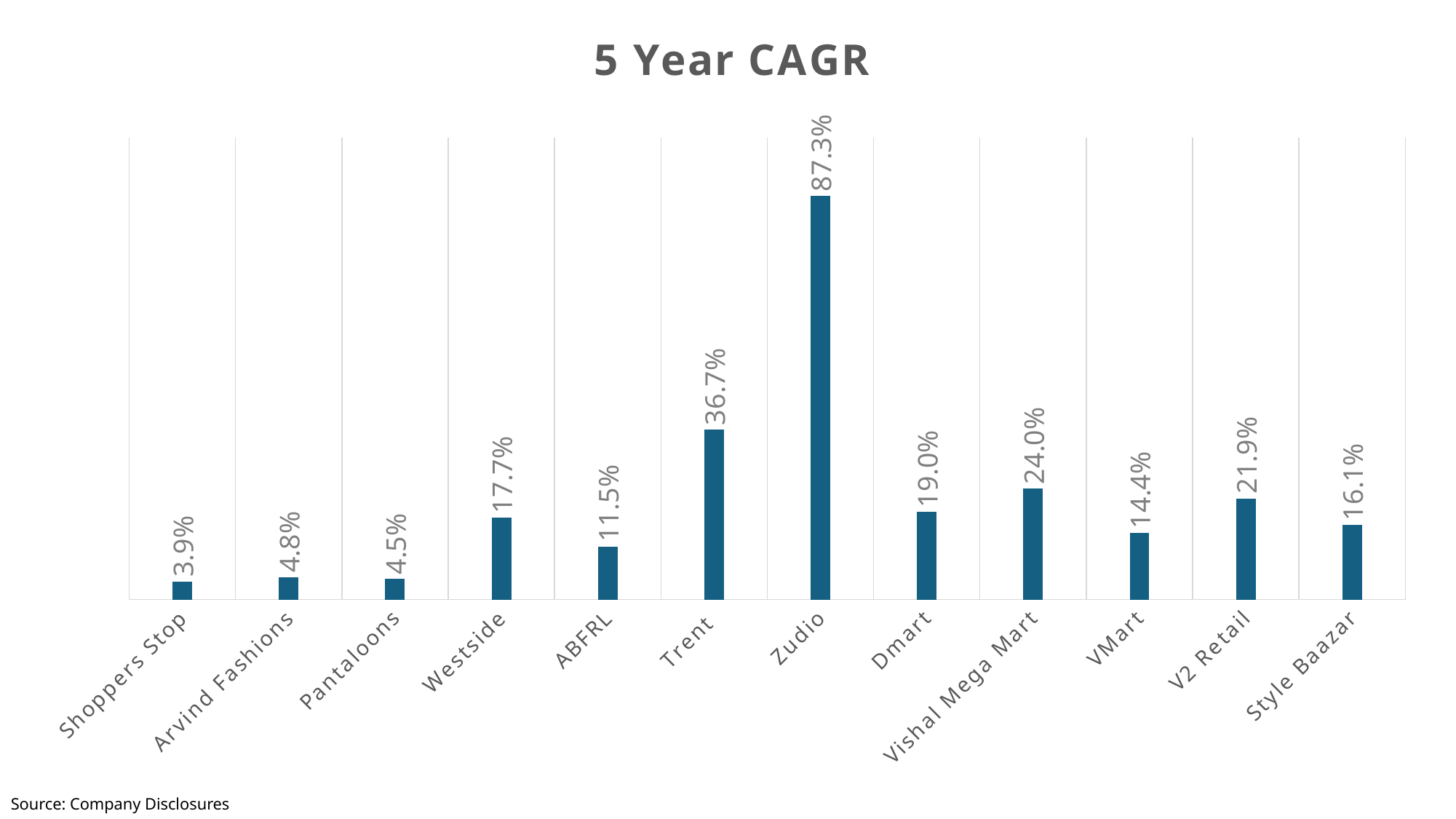
What is the 5 Year CAGR for Shoppers Stop? 3.9% What is the 5 Year CAGR for Vishal Mega Mart? 24.0% Which has a higher 5 Year CAGR, V2 Retail or Dmart? V2 Retail Which company has the highest 5 Year CAGR? Zudio What type of chart is shown on the slide? Bar chart What is the difference between the 5 Year CAGR of Trent and Westside? 19.0% What is the title of the chart? 5 Year CAGR Which company has the lowest 5 Year CAGR? Shoppers Stop What is the 5 Year CAGR for ABFRL? 11.5% What is the difference between the 5 Year CAGR of Zudio and Trent? 50.6% How many companies are shown in the chart? 12 What is the 5 Year CAGR for Zudio? 87.3%